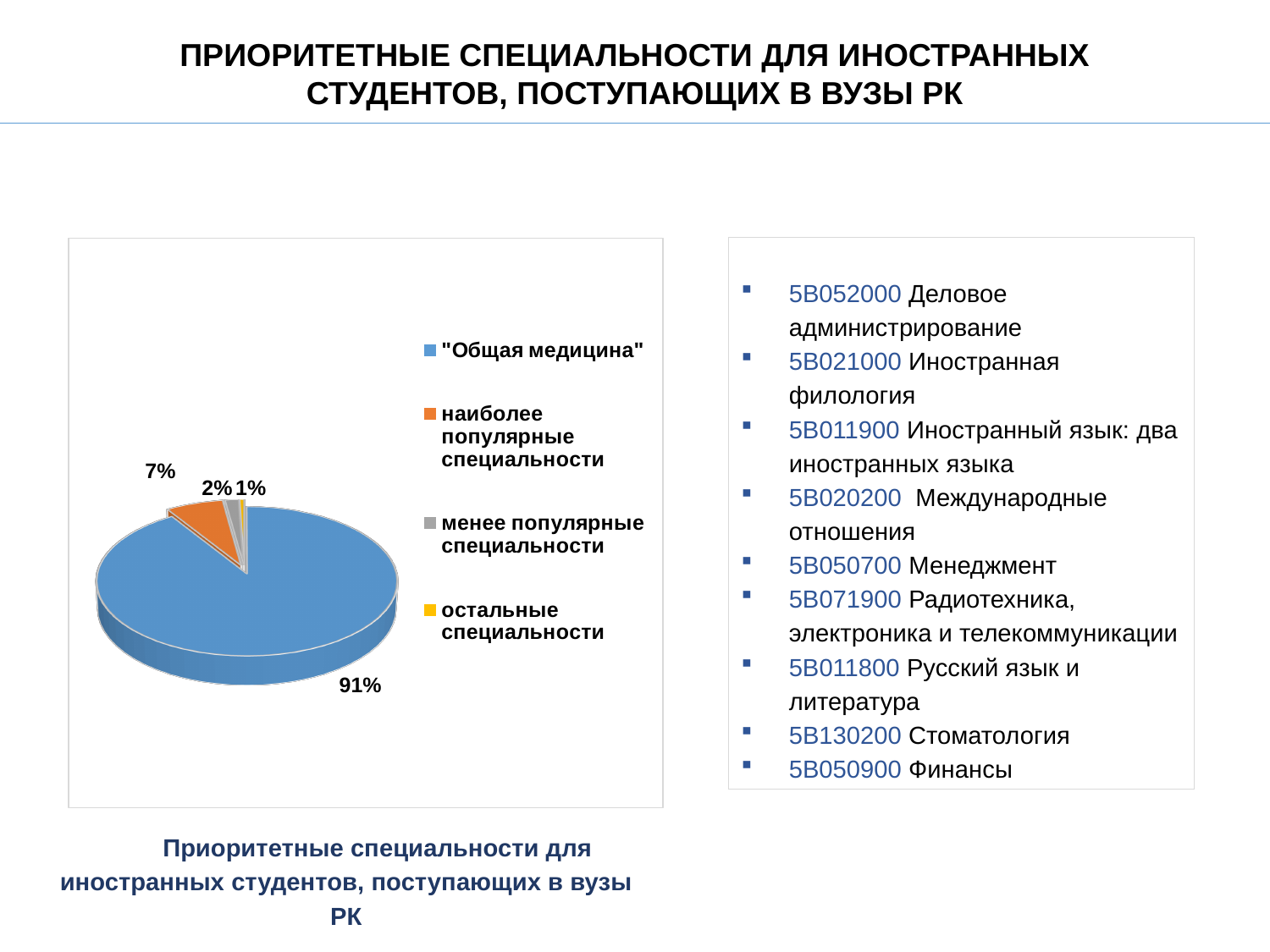
Which category has the smallest slice of the pie? остальные специальности What is the difference in percentage points between "Общая медицина" and наиболее популярные специальности? 84 What share of the pie do наиболее популярные специальности have? 7% What kind of chart is shown on the slide? pie chart How many slices does the pie chart have? 4 Which is larger: the share for наиболее популярные специальности or for менее популярные специальности? наиболее популярные специальности What share of the pie do остальные специальности have? 1% What colour is the slice for "Общая медицина"? blue What share of the pie do менее популярные специальности have? 2% What share of the pie does "Общая медицина" have? 91% Which category has the largest slice of the pie? "Общая медицина" How many entries does the legend list? 4